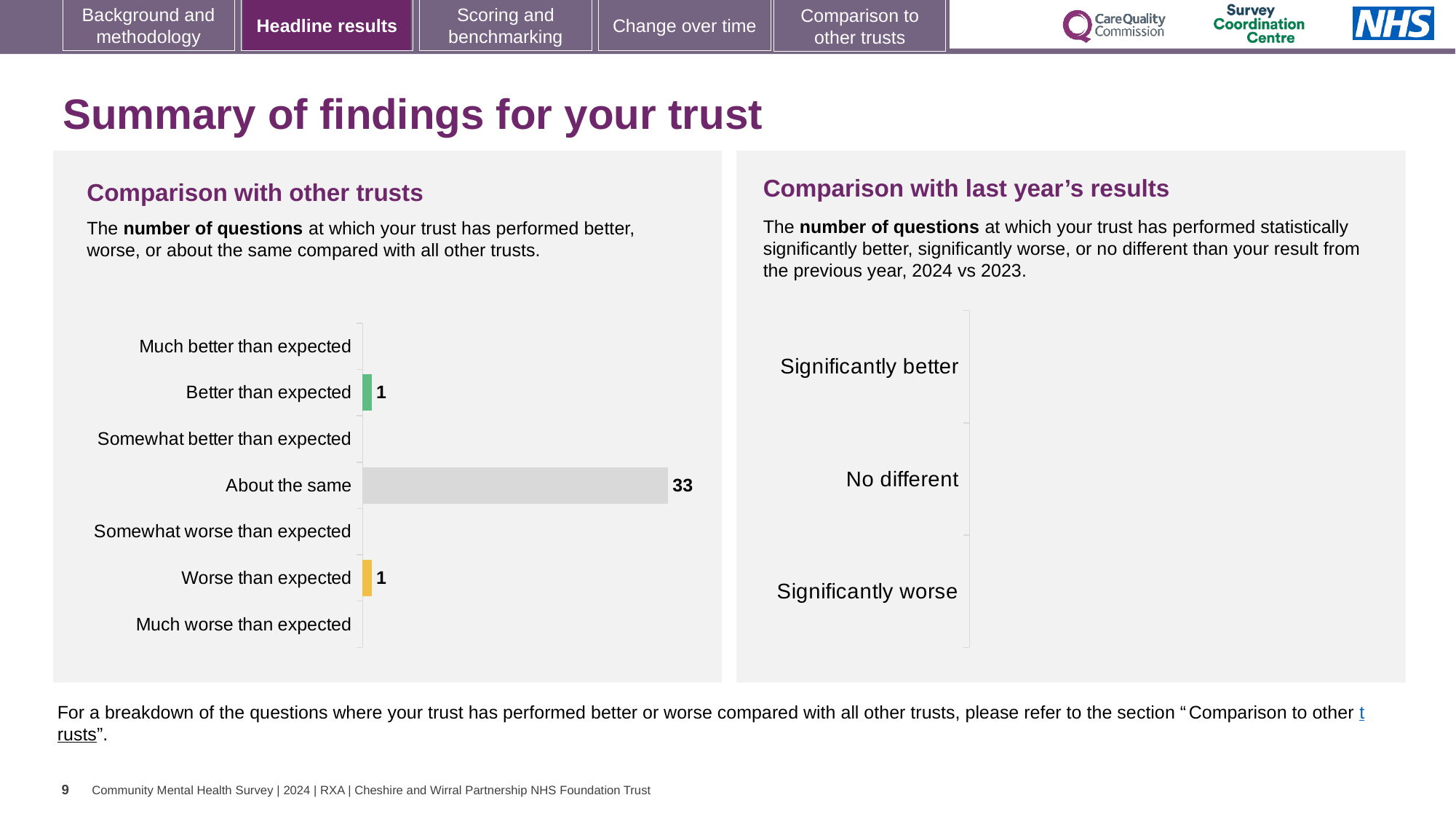
In the 'Comparison with other trusts' chart, how many questions are 'About the same'? 33 What kind of chart is the 'Comparison with other trusts' chart? Bar chart In the 'Comparison with other trusts' chart, which category has the highest value? About the same In the 'Comparison with last year's results' chart, how many categories are listed on the vertical axis? 3 What is the title of the chart on the right side of the slide? Comparison with last year's results In the 'Comparison with other trusts' chart, what colour is the bar for 'Better than expected'? Green In the 'Comparison with other trusts' chart, what is the value for 'Better than expected'? 1 In the 'Comparison with other trusts' chart, how many categories are listed on the vertical axis? 7 In the 'Comparison with other trusts' chart, what is the difference between the values for 'About the same' and 'Better than expected'? 32 In the 'Comparison with other trusts' chart, what is the value for 'Worse than expected'? 1 In the 'Comparison with other trusts' chart, which is larger: the value for 'About the same' or the value for 'Worse than expected'? About the same